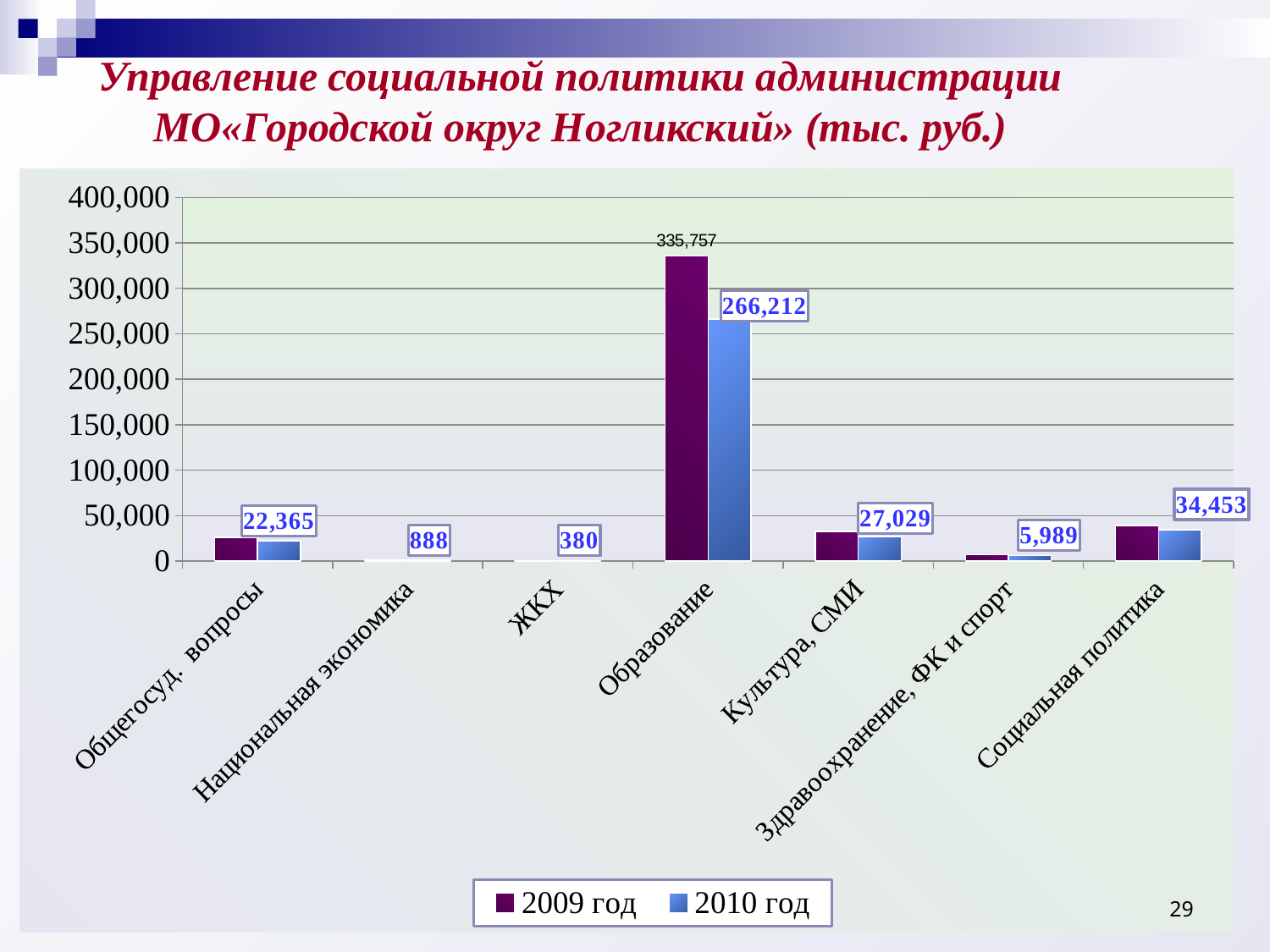
What is the 2010 год value for Социальная политика? 34,453 What is the 2009 год value for Образование? 335,757 Which category has the highest 2010 год value? Образование Which is larger for Образование: the 2009 год value or the 2010 год value? 2009 год Which category has the lowest 2010 год value? ЖКХ What is the 2010 год value for Образование? 266,212 What is the 2010 год value for Здравоохранение, ФК и спорт? 5,989 How many categories are shown on the x axis? 7 What is the 2010 год value for ЖКХ? 380 How many series does the legend list? 2 What is the difference between the 2009 год and 2010 год values for Образование? 69,545 Is the 2009 год value for Культура, СМИ greater or less than 50,000? less